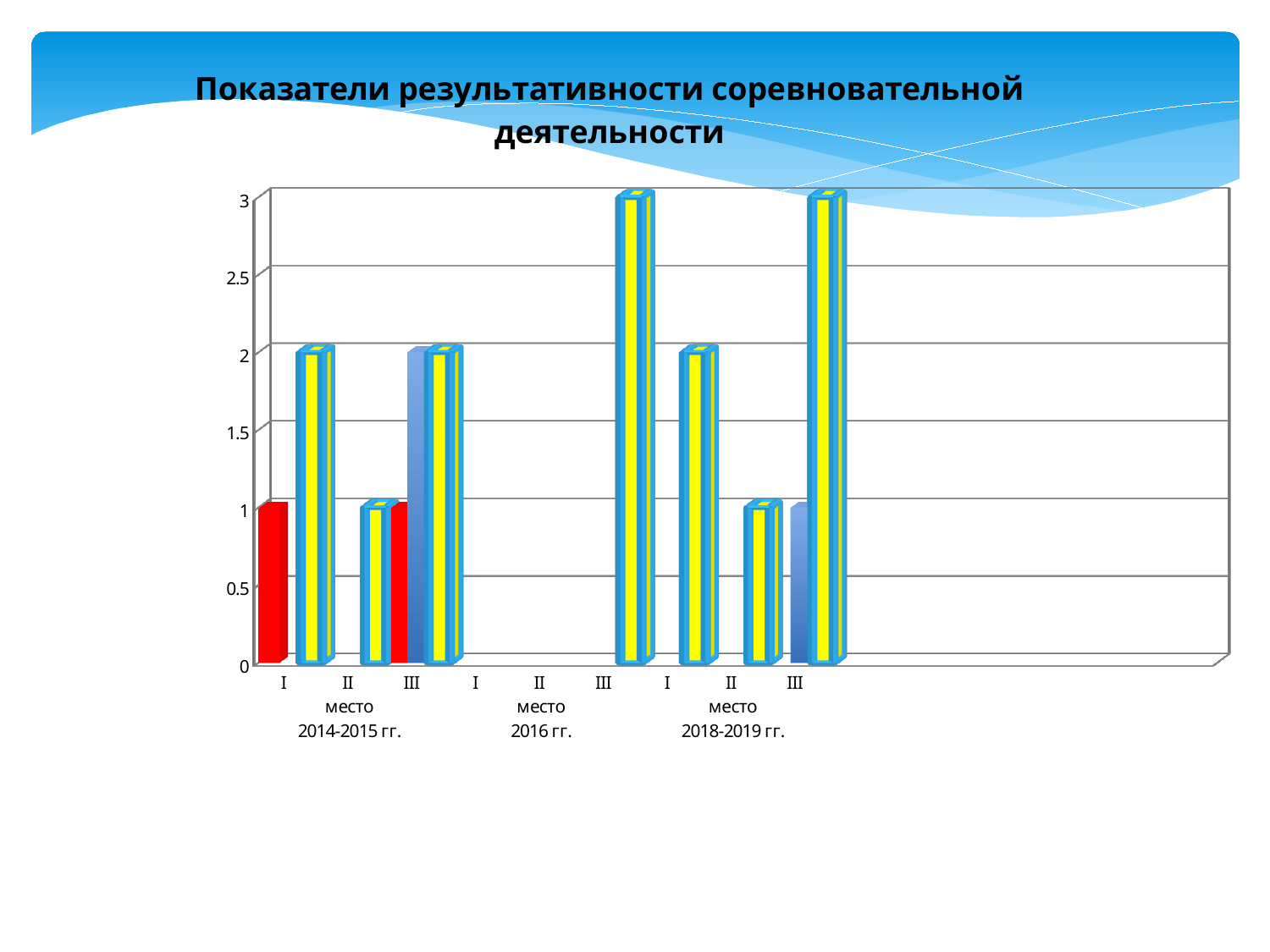
Does any bar in the chart exceed the value 3? No What is the highest value reached by any bar in the chart? 3 What is the title of the chart on the slide? Показатели результативности соревновательной деятельности What is the highest tick shown on the vertical axis? 3 How many year groups are labelled along the x axis of the chart? 3 Which year groups are labelled along the x axis? 2014-2015 гг., 2016 гг., 2018-2019 гг. What kind of chart is shown on the slide? bar chart How many bars in the chart reach the value 3? 2 Is the value of the first (red) bar on the left greater or less than 1.5? less What is the lowest value reached by any bar in the chart? 1 What value does the first (red) bar on the left reach? 1